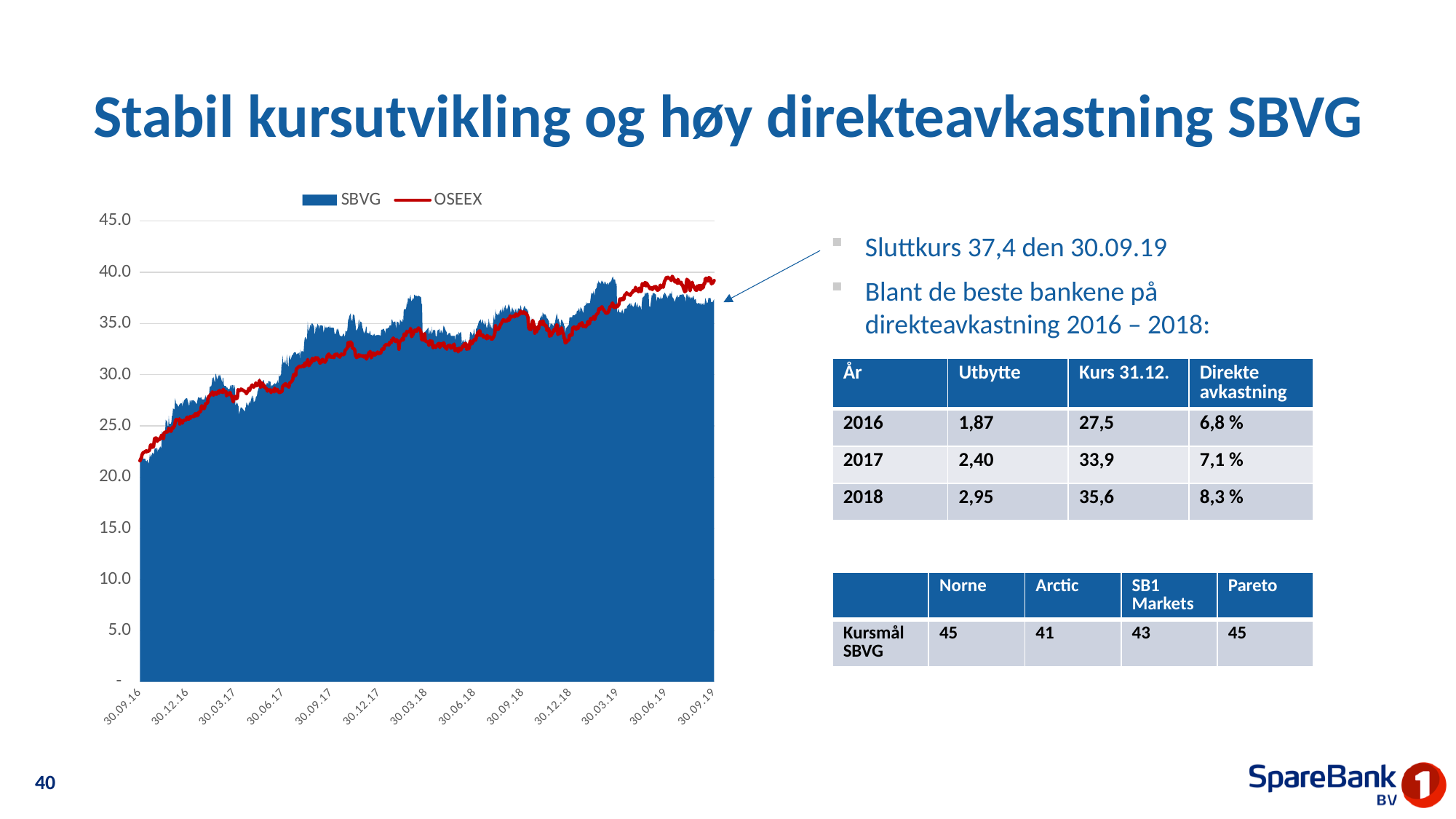
How many date labels are shown on the x axis of the chart? 13 Which two series are shown in the chart legend? SBVG and OSEEX What is the SBVG closing price (sluttkurs) on 30.09.19 as annotated on the chart? 37,4 What colour is the OSEEX series in the chart? Red Does the SBVG series generally rise or fall from 30.09.16 to 30.09.19? Rise Is the SBVG value at 30.09.16 greater or less than 25.0? less How many series does the chart legend list? 2 At 30.09.19, which series is higher, SBVG or OSEEX? OSEEX Is the OSEEX value at 30.09.19 greater or less than 35.0? greater Is the SBVG value at 30.12.16 greater or less than 30.0? less What is the highest value shown on the chart's y axis? 45.0 What kind of chart is shown on the slide? An area chart with a line series